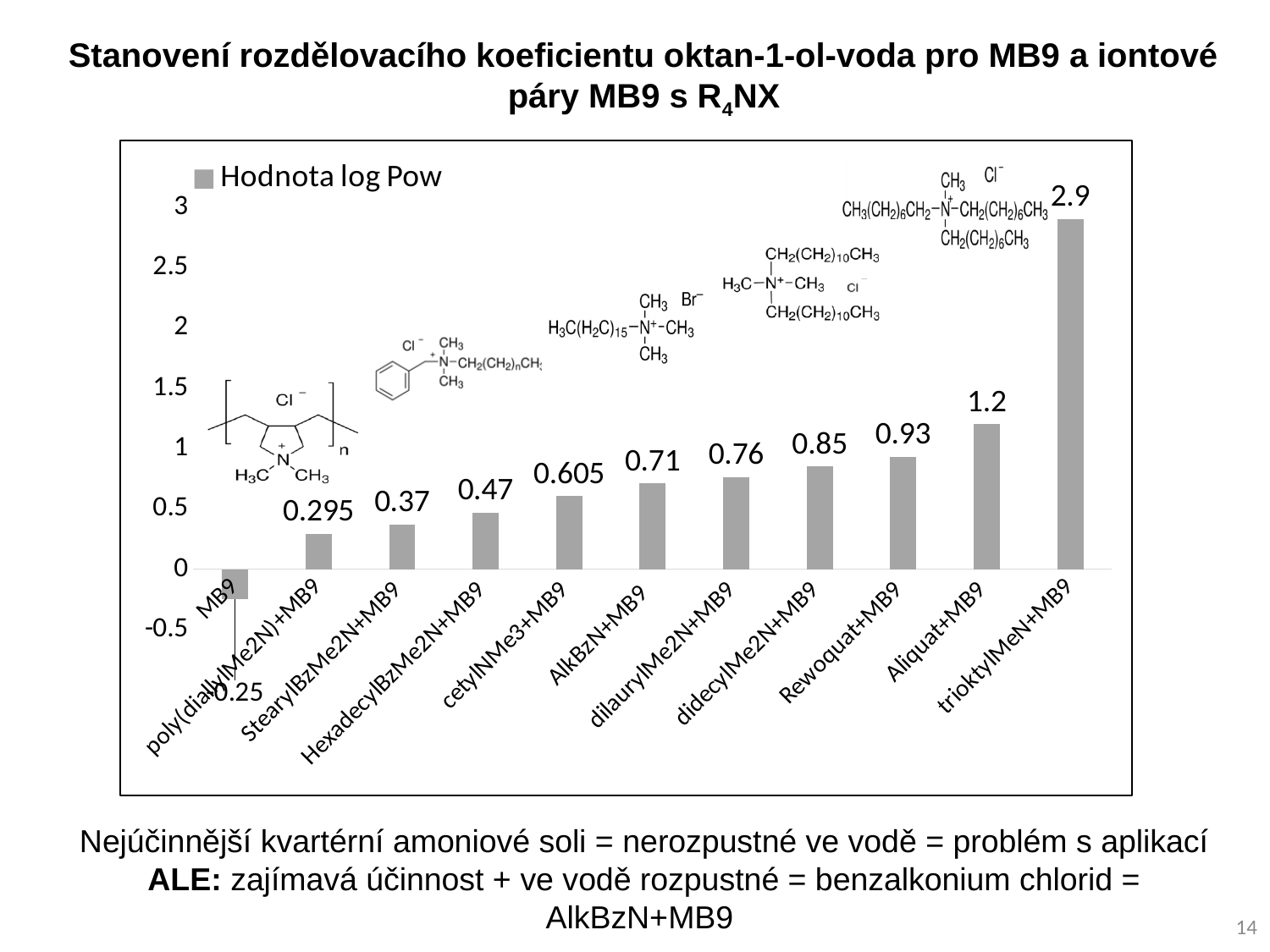
What is the name of the series shown in the legend? Hodnota log Pow What is the log Pow value for AlkBzN+MB9? 0.71 Which has a higher log Pow value, Rewoquat+MB9 or didecylMe2N+MB9? Rewoquat+MB9 Which category has the lowest log Pow value? MB9 How many categories are plotted in the chart? 11 Which category has the highest log Pow value? trioktylMeN+MB9 What is the log Pow value for MB9 alone? -0.25 How many series does the legend list? 1 What is the log Pow value for trioktylMeN+MB9? 2.9 What is the difference between the log Pow values of trioktylMeN+MB9 and Aliquat+MB9? 1.7 What is the log Pow value for cetylNMe3+MB9? 0.605 What kind of chart is shown on the slide? bar chart